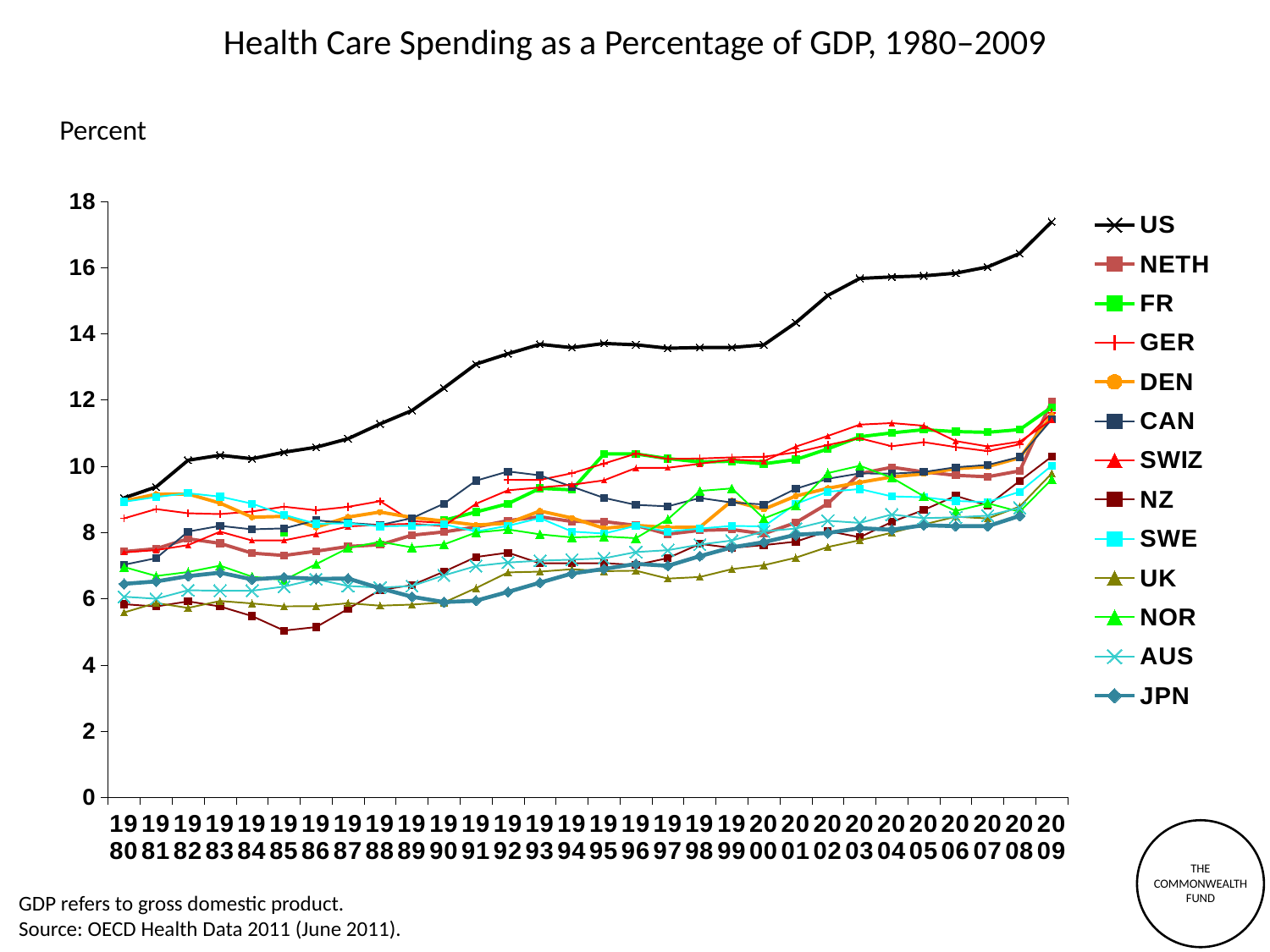
Is the value for the US in 2009 greater or less than 16? greater How many series does the legend list? 13 What is the title of the chart? Health Care Spending as a Percentage of GDP, 1980–2009 What is the label on the y axis of the chart? Percent Is the value for NZ in 1985 greater or less than 6? less Is the value for the US in 2000 greater or less than 12? greater Does the US line rise or fall from 1980 to 2009? rises Which country has the highest health care spending as a percentage of GDP in 2009? US What kind of chart is shown on the slide? line chart How many years are plotted along the x axis? 30 In 2009, which is larger: the value for the US or the value for the UK? US